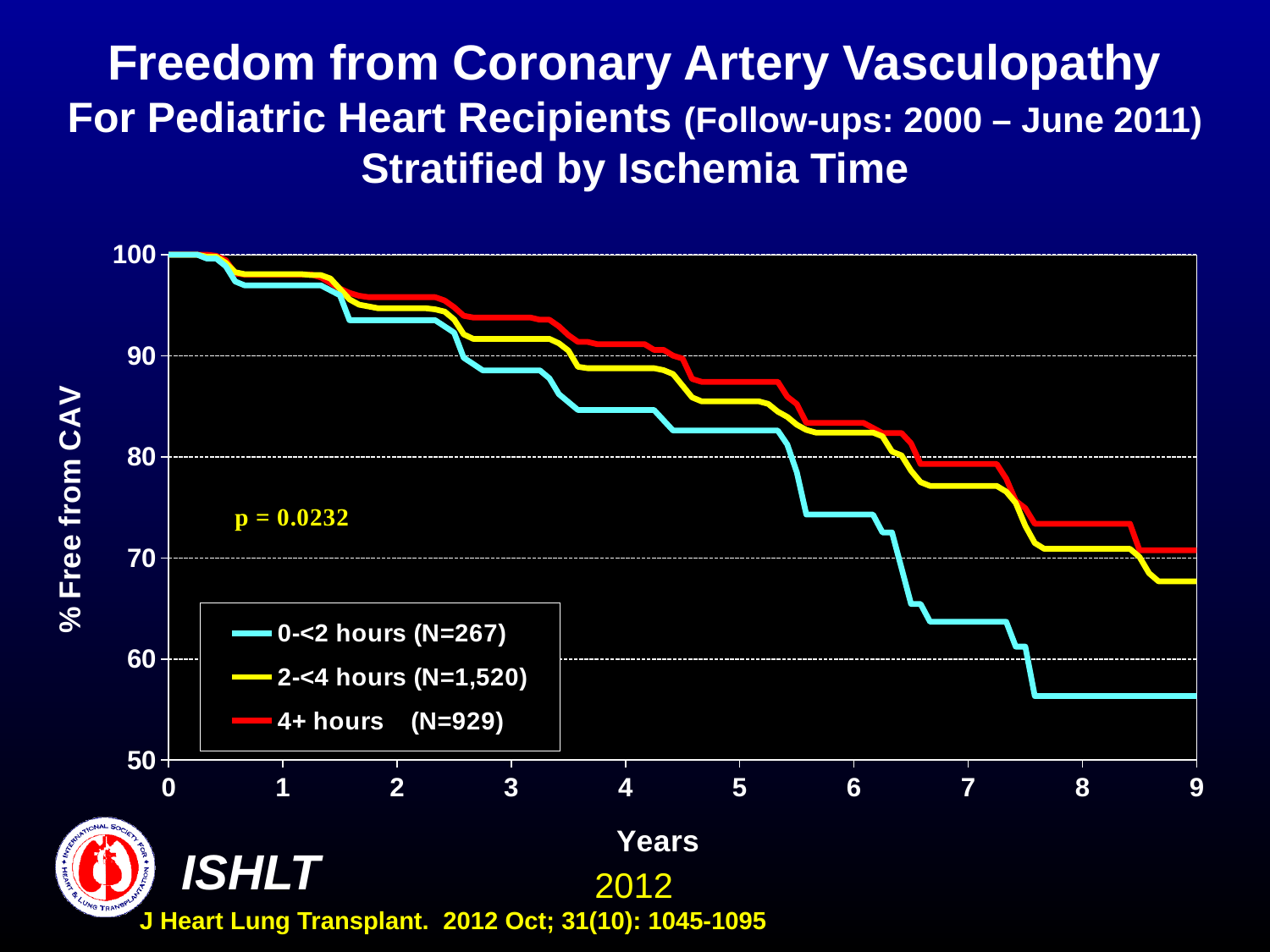
Is the value for the 2-<4 hours series at year 9 greater or less than 70? less How many series does the legend list? 3 Is the value for the 0-<2 hours series at year 3 greater or less than 90? less Is the value for the 0-<2 hours series at year 9 greater or less than 60? less At year 9, which series has the lowest % free from CAV? 0-<2 hours Do the values for the 0-<2 hours series rise or fall as years increase? fall What p-value is shown on the chart? p = 0.0232 What kind of chart is shown on the slide? line chart At year 8, which is larger: the value for 2-<4 hours or the value for 0-<2 hours? 2-<4 hours What is the N for the 2-<4 hours group shown in the legend? N=1,520